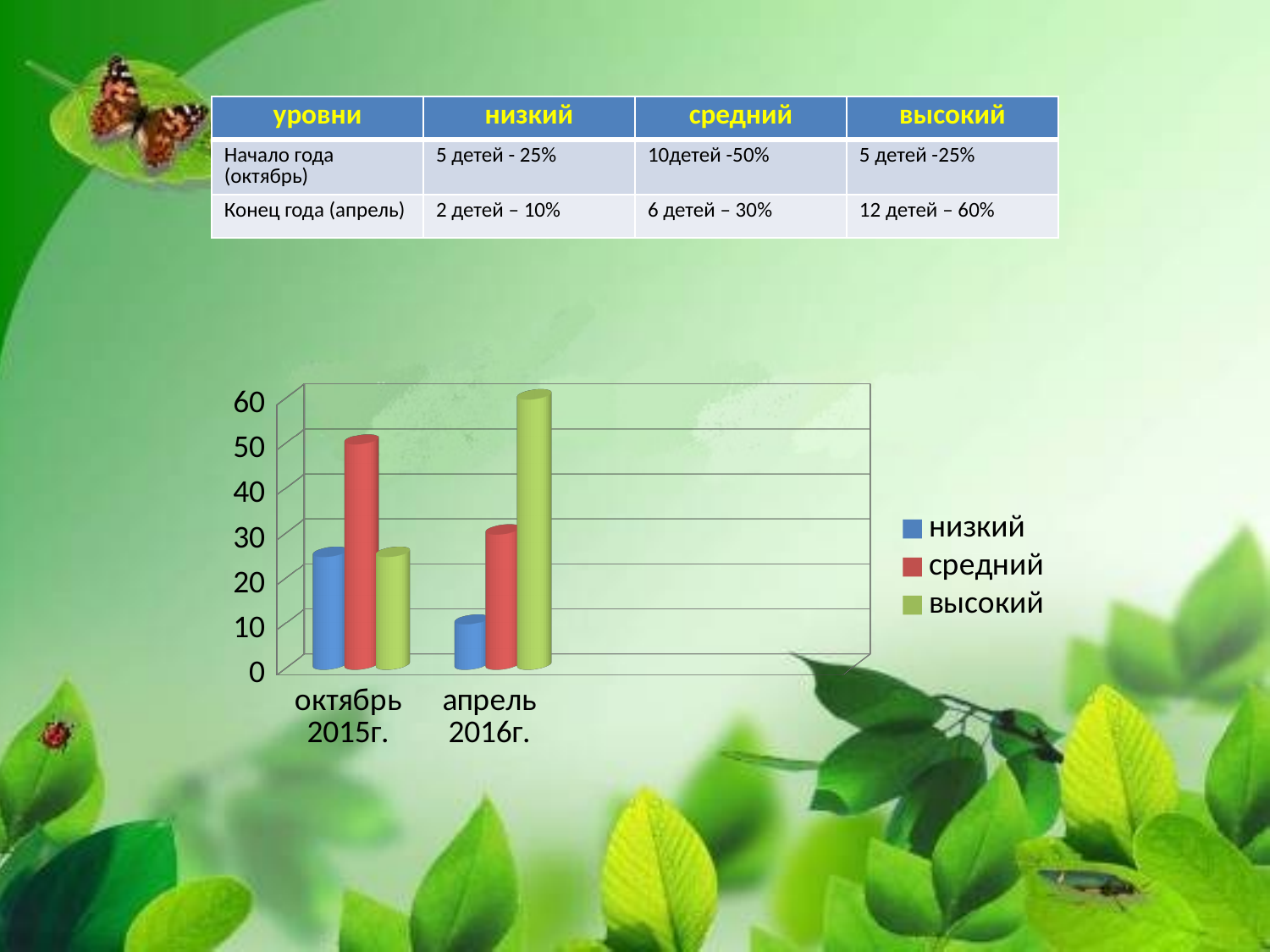
How many series does the chart legend list? 3 What is the value of the высокий bar for апрель 2016г.? 60 Is the value of the низкий bar for октябрь 2015г. greater or less than 30? less What kind of chart is shown on the slide? bar chart How many categories are shown on the x axis of the chart? 2 Which series has the highest bar for октябрь 2015г.? средний What is the value of the низкий bar for апрель 2016г.? 10 What is the value of the средний bar for октябрь 2015г.? 50 What is the value of the средний bar for апрель 2016г.? 30 Which series has the lowest bar for апрель 2016г.? низкий Does the высокий series rise or fall from октябрь 2015г. to апрель 2016г.? rises What is the difference between the высокий and средний bars for апрель 2016г.? 30